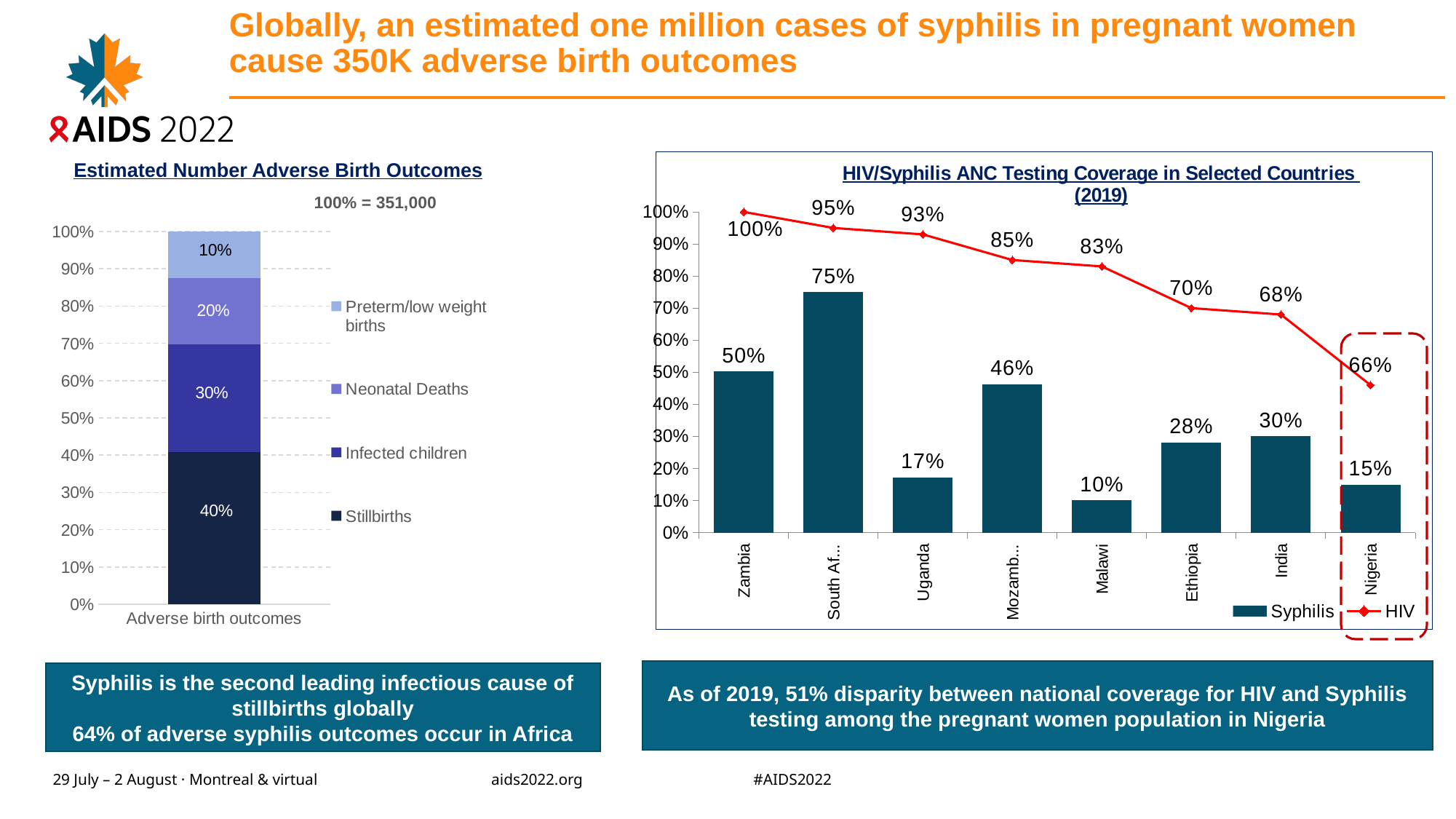
In the 'HIV/Syphilis ANC Testing Coverage in Selected Countries (2019)' chart, what is the Syphilis testing coverage for Zambia? 50% In the 'HIV/Syphilis ANC Testing Coverage in Selected Countries (2019)' chart, what is the difference between HIV and Syphilis testing coverage in Nigeria? 51% In the 'Estimated Number Adverse Birth Outcomes' chart, what percentage is shown for Neonatal Deaths? 20% In the 'HIV/Syphilis ANC Testing Coverage in Selected Countries (2019)' chart, what is the HIV testing coverage for Nigeria? 66% In the 'Estimated Number Adverse Birth Outcomes' chart, what percentage is shown for Stillbirths? 40% In the 'HIV/Syphilis ANC Testing Coverage in Selected Countries (2019)' chart, which is larger: Syphilis coverage in India or in Ethiopia? India In the 'Estimated Number Adverse Birth Outcomes' chart, how many categories does the legend list? 4 In the 'HIV/Syphilis ANC Testing Coverage in Selected Countries (2019)' chart, how many countries are shown? 8 In the 'HIV/Syphilis ANC Testing Coverage in Selected Countries (2019)' chart, which country has the lowest Syphilis testing coverage? Malawi In the 'Estimated Number Adverse Birth Outcomes' chart, which category has the smallest share? Preterm/low weight births In the 'Estimated Number Adverse Birth Outcomes' chart, what total does 100% correspond to? 351,000 In the 'HIV/Syphilis ANC Testing Coverage in Selected Countries (2019)' chart, which country has the highest HIV testing coverage? Zambia